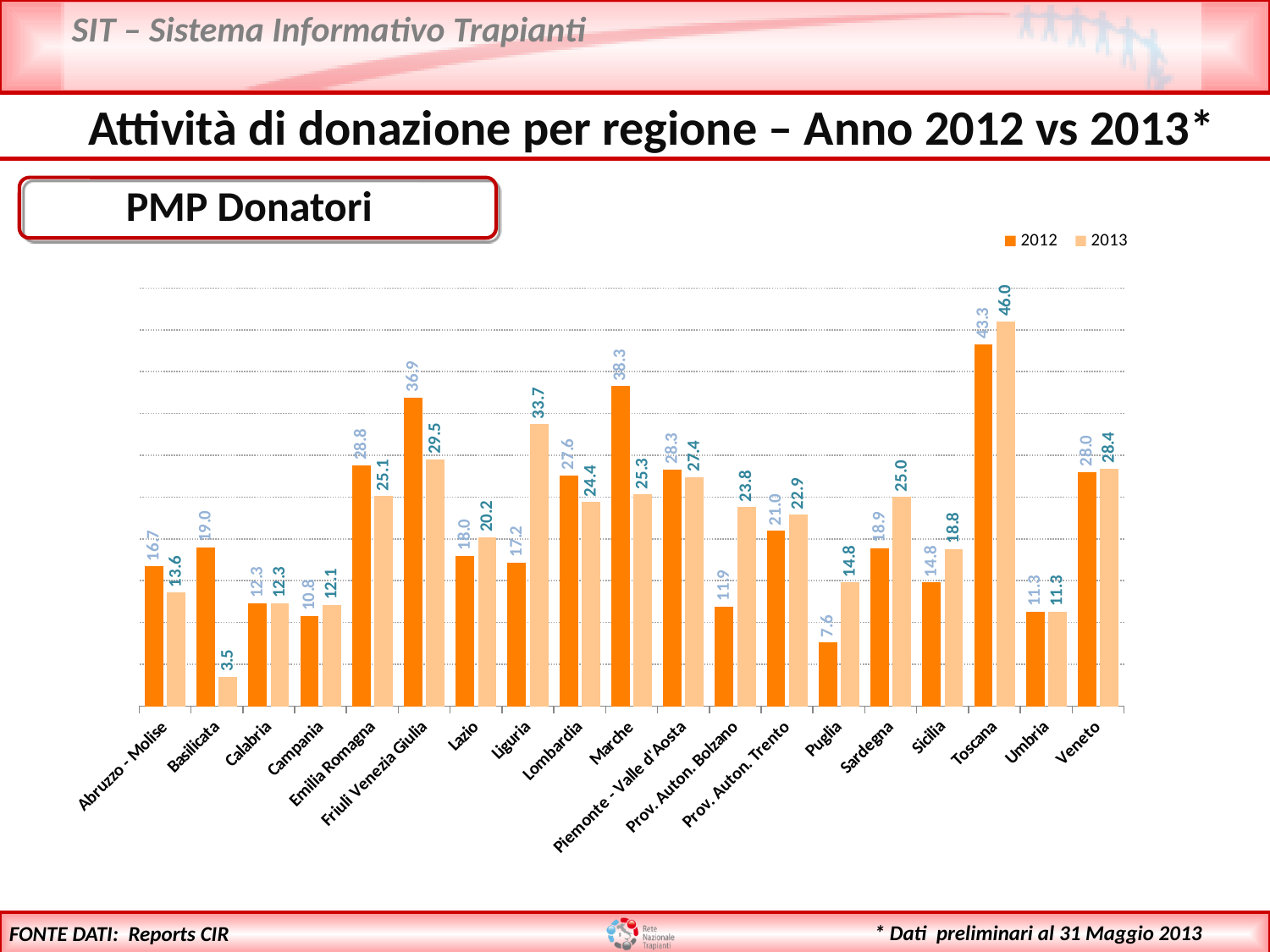
For Liguria, which year has the larger value, 2012 or 2013? 2013 What is the difference between the 2012 and 2013 values for Basilicata? 15.5 What kind of chart is shown on the slide? bar chart Which region has the lowest 2013 value? Basilicata What is the difference between the 2013 and 2012 values for Toscana? 2.7 What is the 2013 value for Toscana? 46.0 How many series does the legend list? 2 What are the two entries in the legend? 2012 and 2013 What is the 2013 value for Liguria? 33.7 Which region has the highest 2013 value? Toscana What is the 2013 value for Friuli Venezia Giulia? 29.5 How many regions are shown on the x axis? 19